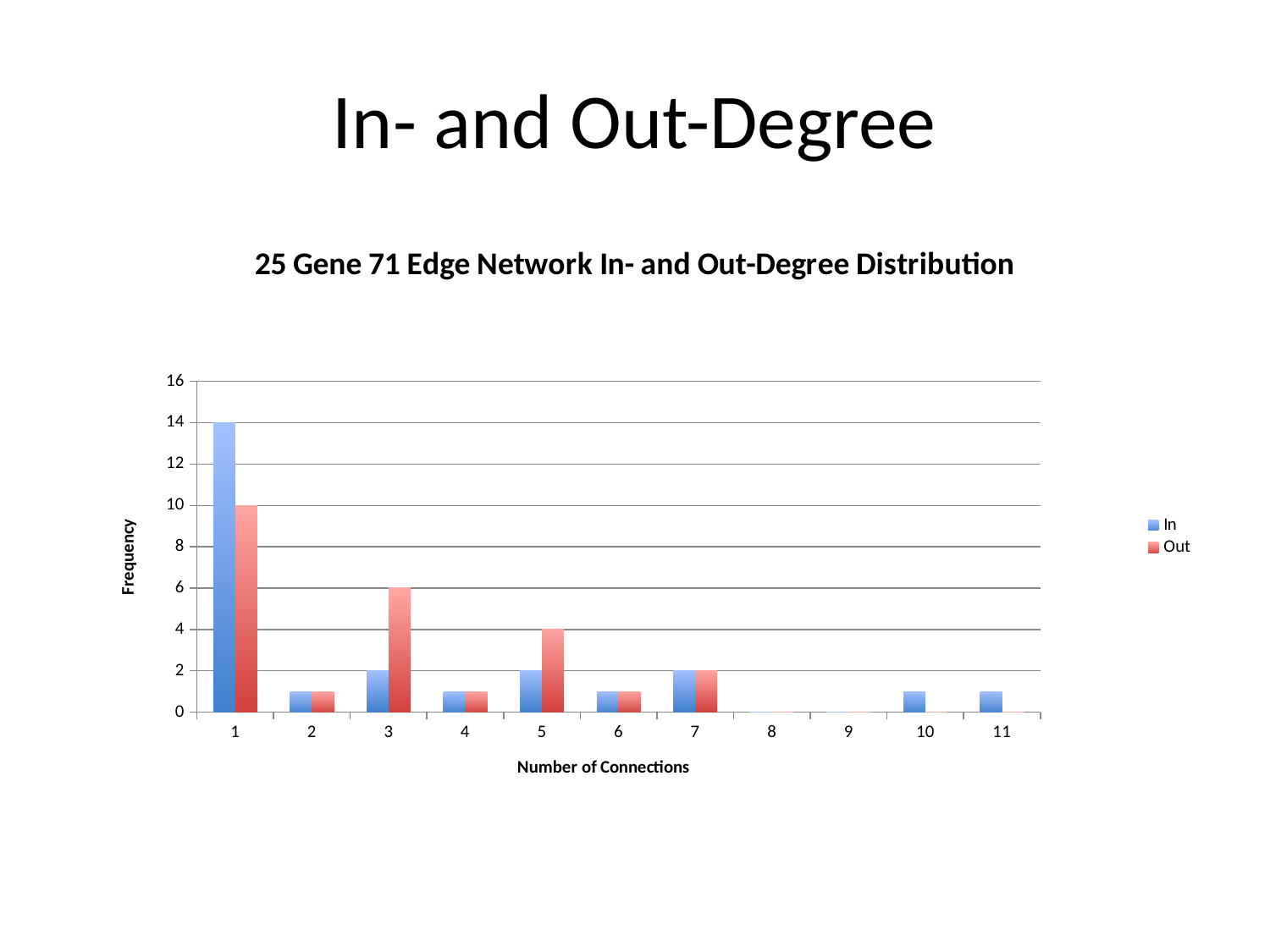
What is the Out frequency for 3 connections? 6 Which number of connections has the highest In frequency? 1 What is the Out frequency for 1 connection? 10 For 3 connections, which series has the larger frequency, In or Out? Out How many series does the legend list? 2 How many categories are shown on the x axis? 11 What is the In frequency for 1 connection? 14 What type of chart is shown on the slide? bar chart What is the difference between the In and Out frequencies for 1 connection? 4 What is the title of the chart? 25 Gene 71 Edge Network In- and Out-Degree Distribution What is the Out frequency for 5 connections? 4 Is the In frequency for 10 connections greater or less than 2? less